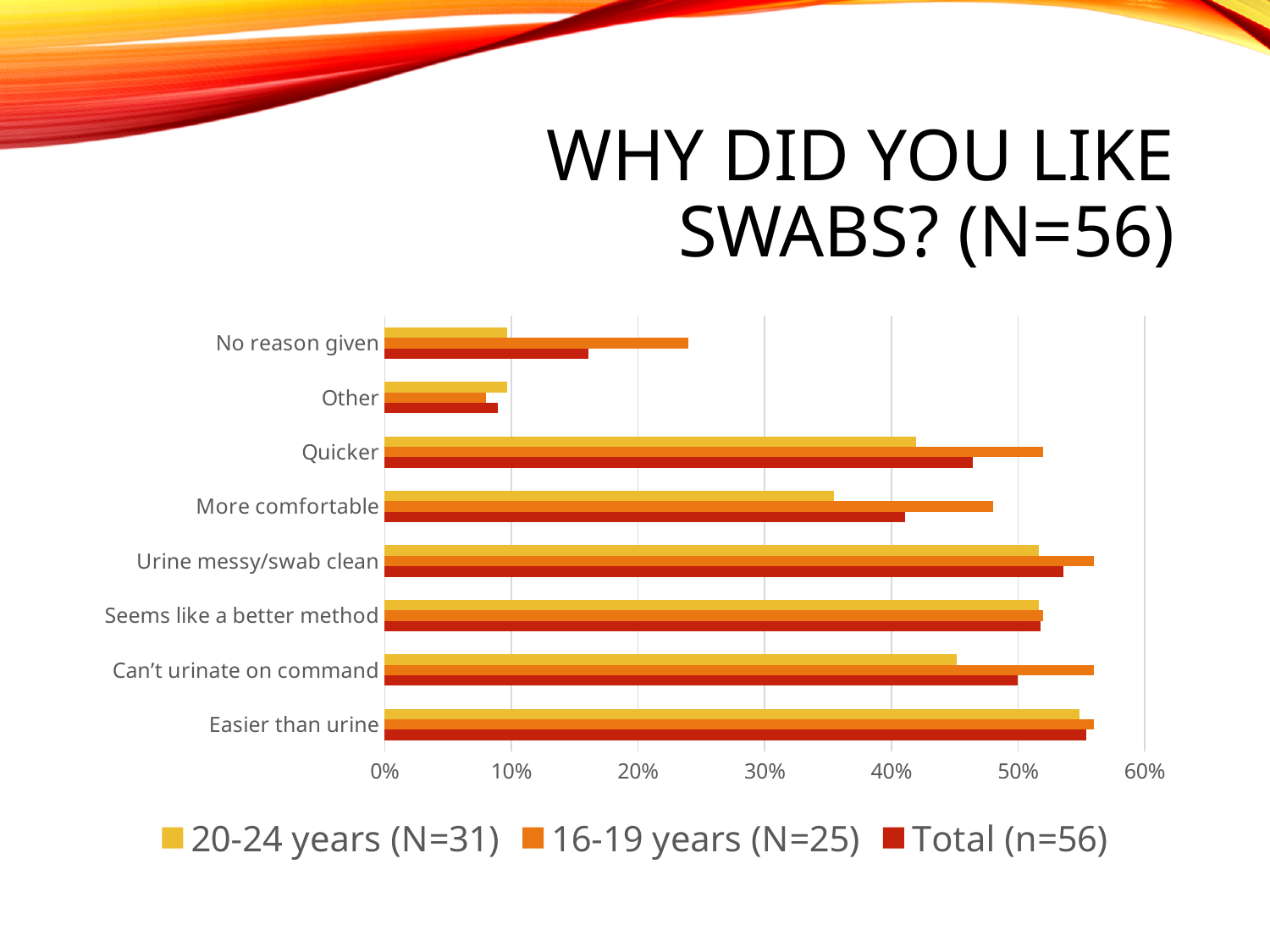
Is the value for 'No reason given' in the 16-19 years (N=25) series greater or less than 20%? greater What is the title of the chart? WHY DID YOU LIKE SWABS? (N=56) Is the value for 'More comfortable' in the 20-24 years (N=31) series greater or less than 40%? less For 'More comfortable', which series has the larger value: 20-24 years (N=31) or 16-19 years (N=25)? 16-19 years (N=25) How many categories (reasons) are listed on the chart? 8 How many series does the legend list? 3 For 'No reason given', which series has the larger value: 20-24 years (N=31) or 16-19 years (N=25)? 16-19 years (N=25) Which series is shown in the darkest red colour in the legend? Total (n=56) Is the value for 'Other' in the 16-19 years (N=25) series greater or less than 10%? less What kind of chart is shown on the slide? Bar chart Which category has the lowest value in the Total (n=56) series? Other